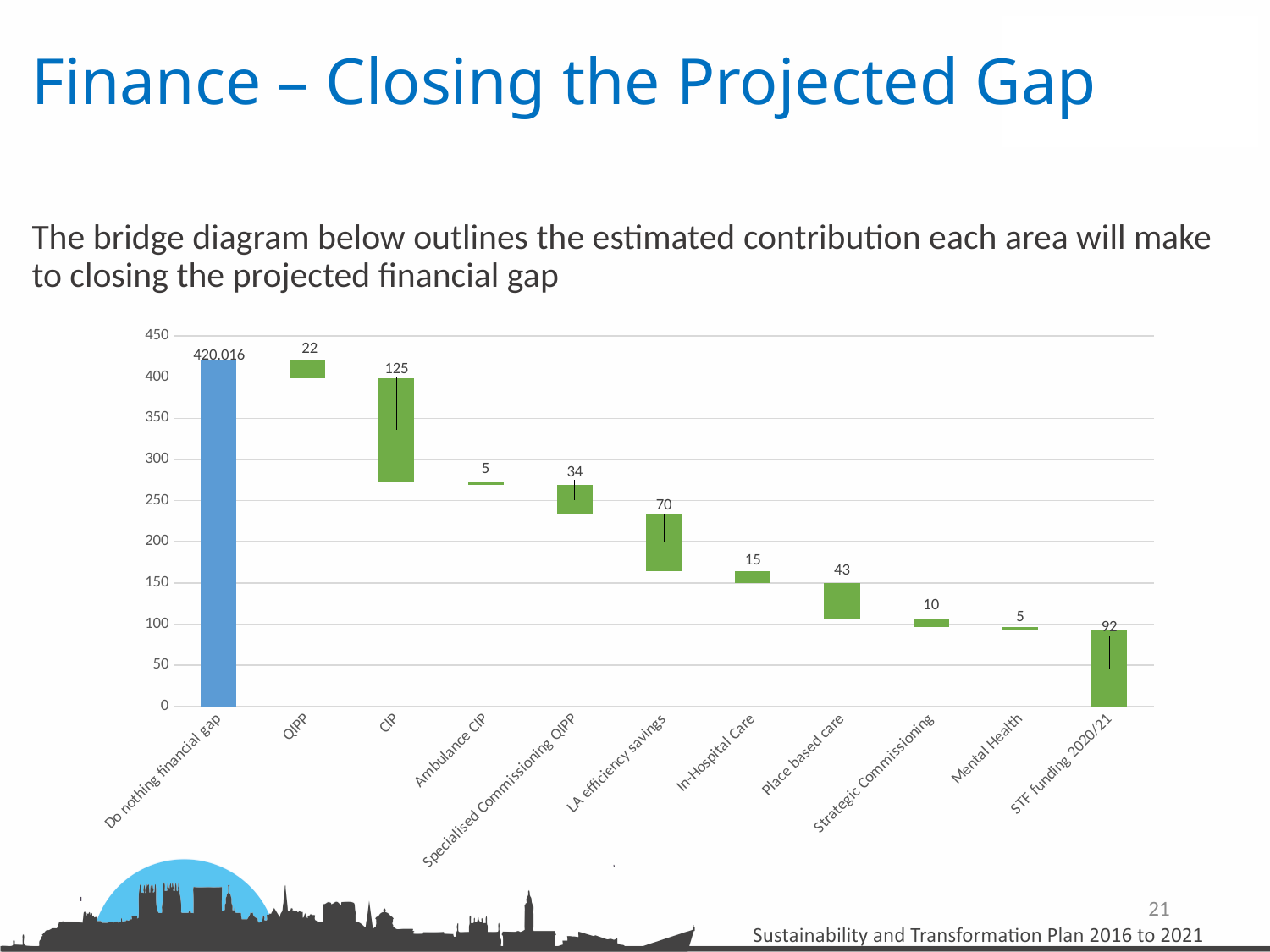
What is the value shown for LA efficiency savings? 70 How many categories are shown along the x axis of the chart? 11 What is the value shown for STF funding 2020/21? 92 What is the value shown for CIP? 125 Which is larger, the value for LA efficiency savings or the value for Place based care? LA efficiency savings What kind of chart is shown on the slide? Bar chart (waterfall/bridge) What is the value shown for the 'Do nothing financial gap' bar? 420.016 Is the value for 'Do nothing financial gap' greater or less than 400? greater What is the value shown for Specialised Commissioning QIPP? 34 What is the difference between the CIP value and the LA efficiency savings value? 55 What colour is the 'Do nothing financial gap' bar? Blue Which of the green contribution bars has the highest value? CIP